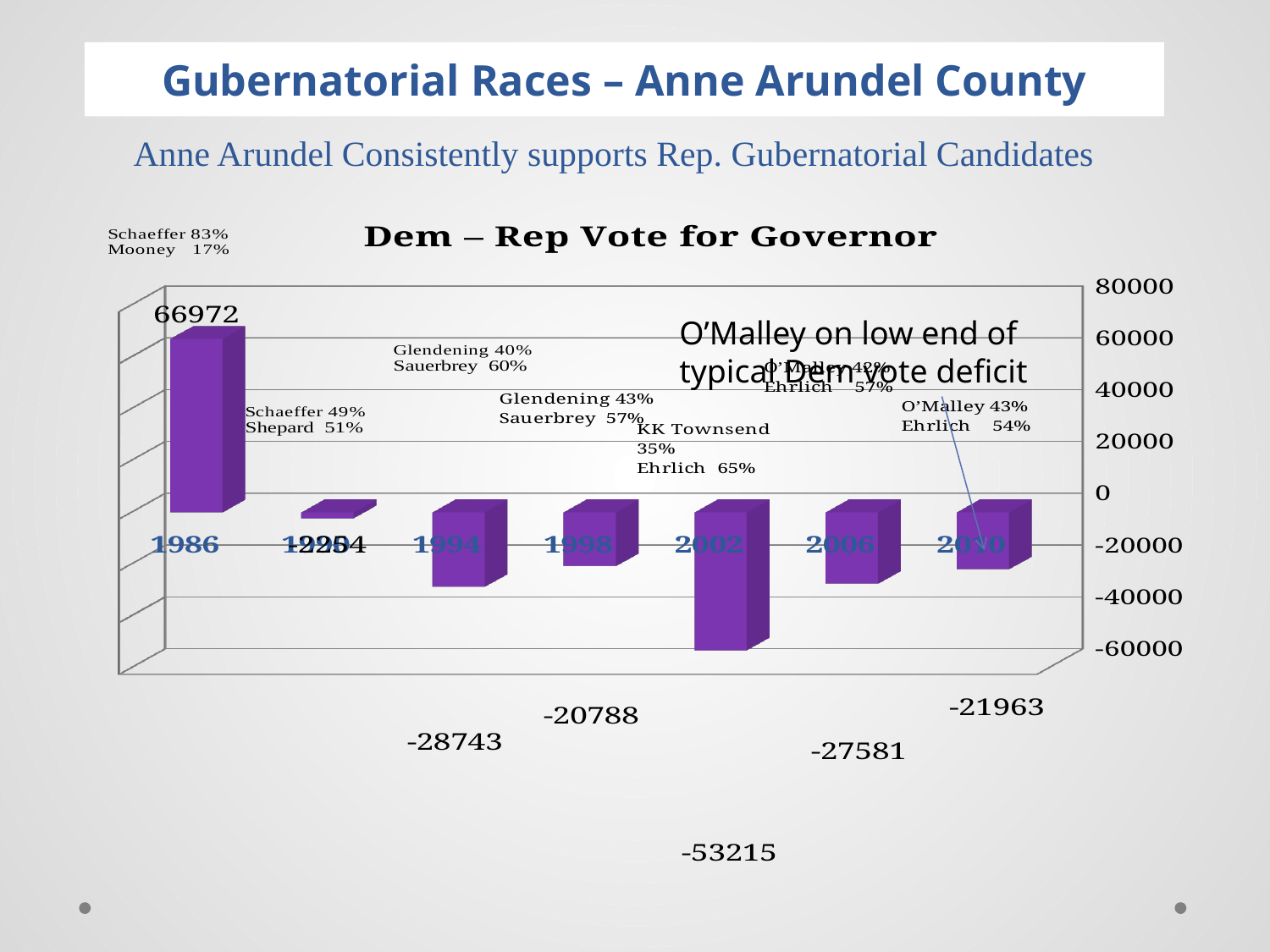
Which year has the higher Dem – Rep vote value, 2006 or 2010? 2010 How many election years are plotted on the chart? 7 What is the Dem – Rep vote value for 2006? -27581 What is the difference between the values for 1994 and 1998? 7955 What is the title of the chart? Dem – Rep Vote for Governor What is the Dem – Rep vote value for 1986? 66972 What is the Dem – Rep vote value for 2002? -53215 Which year has the lowest Dem – Rep vote value? 2002 What is the Dem – Rep vote value for 2010? -21963 What is the Dem – Rep vote value for 1994? -28743 What kind of chart is shown on the slide? bar chart Which year has the highest Dem – Rep vote value? 1986